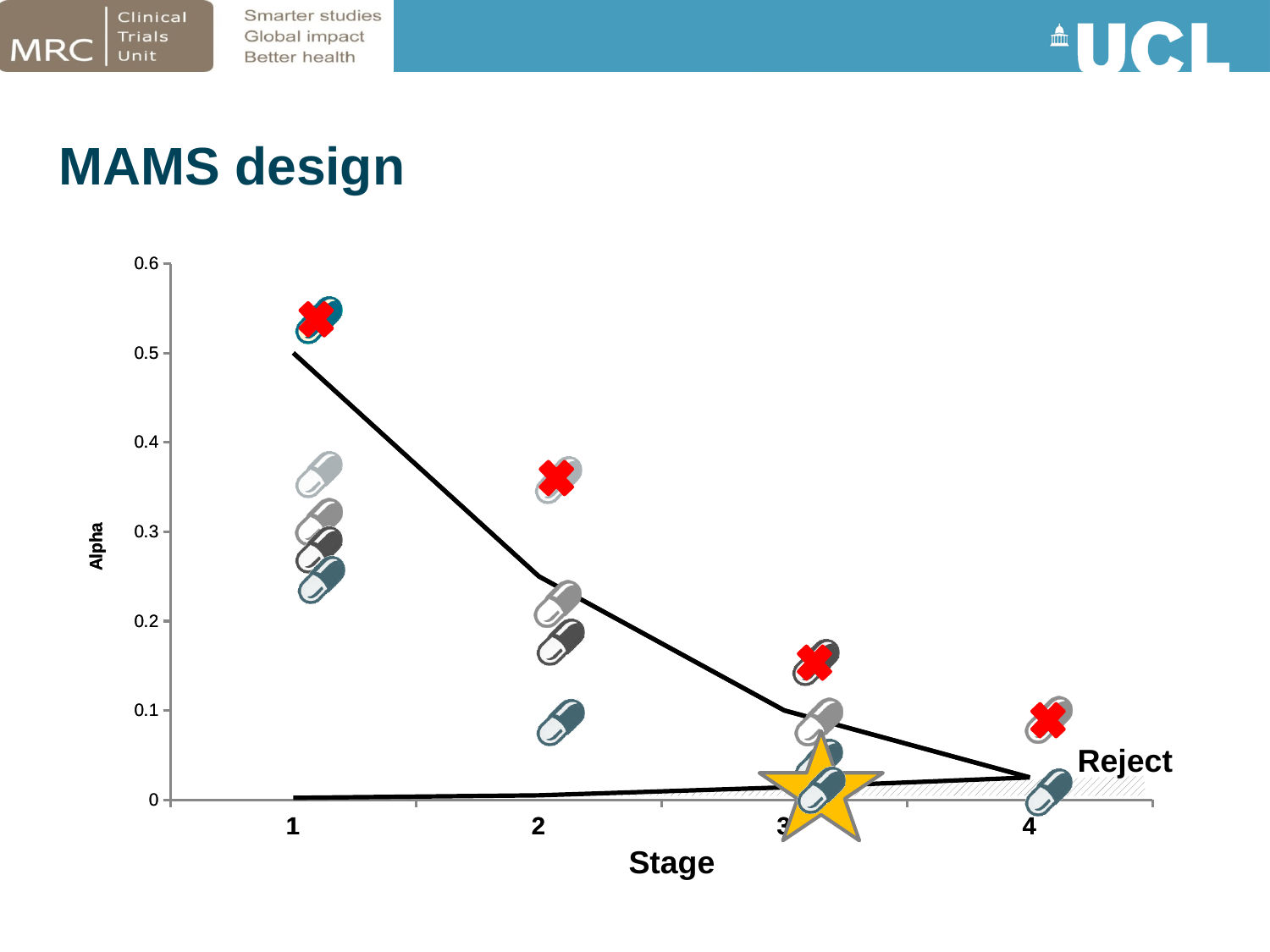
At which stage is the upper black line highest? 1 Is the value of the upper black line at stage 3 greater or less than 0.2? less Is the value of the upper black line at stage 1 greater or less than 0.4? greater What is the title of the slide containing the chart? MAMS design Which is larger, the value of the upper black line at stage 1 or at stage 3? stage 1 Is the value of the upper black line at stage 4 greater or less than 0.1? less What kind of chart is shown on the slide? line chart At which stage is the upper black line lowest? 4 How many stages are marked along the x axis? 4 Does the upper black line rise or fall as the stage increases from 1 to 4? fall What is the label of the x axis? Stage